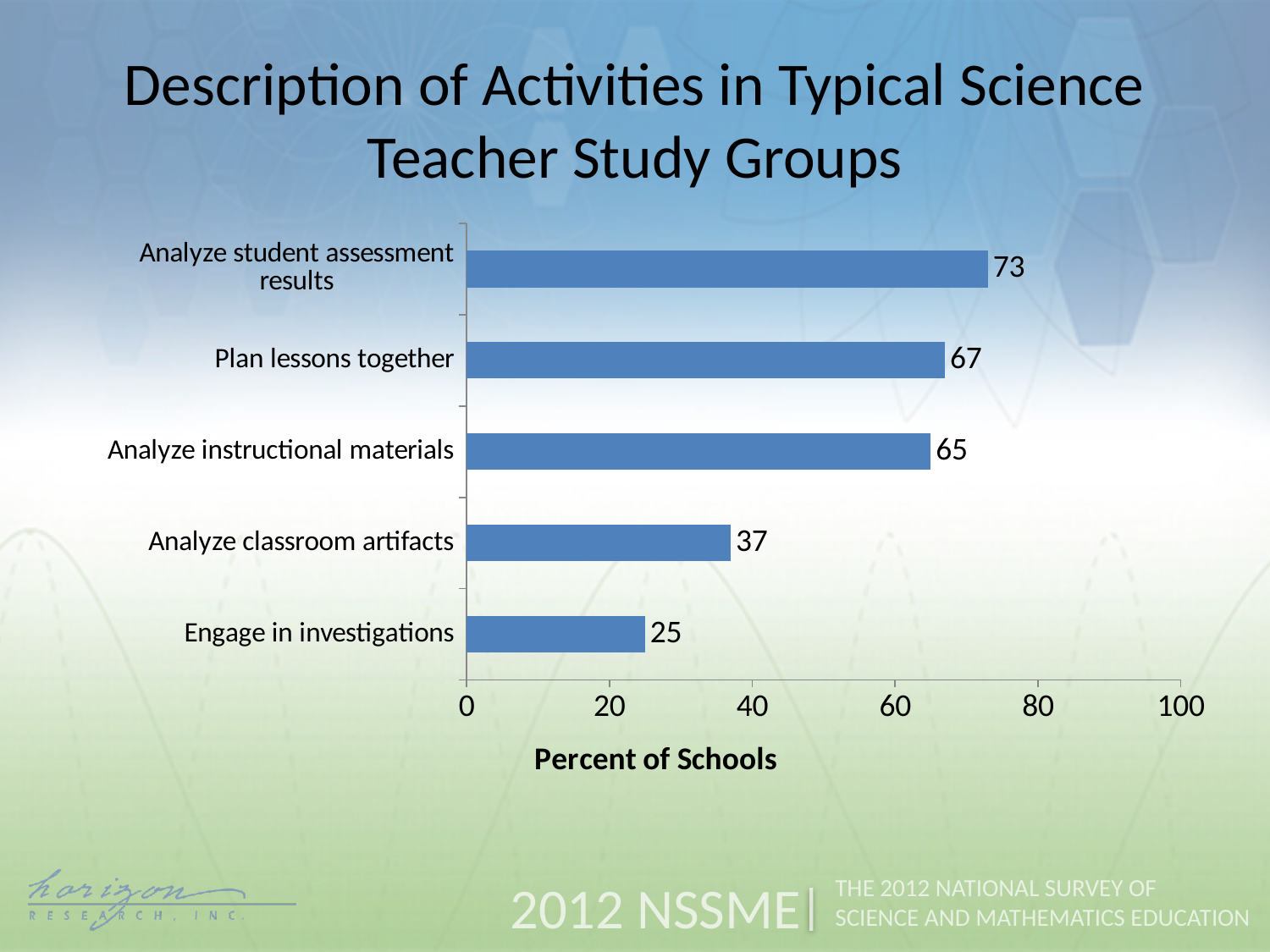
Is the value for Analyze classroom artifacts greater or less than 40? less Which activity has the lowest percent of schools? Engage in investigations What kind of chart is shown on the slide? bar chart How many activities are shown in the chart? 5 What is the value for Plan lessons together? 67 What is the difference between the values for Analyze instructional materials and Analyze classroom artifacts? 28 Which is larger, the value for Plan lessons together or the value for Analyze instructional materials? Plan lessons together What percent of schools report analyzing student assessment results in typical science teacher study groups? 73 What is the value for Engage in investigations? 25 Which activity has the highest percent of schools? Analyze student assessment results What is the label of the horizontal axis? Percent of Schools What is the difference between the highest and lowest values in the chart? 48